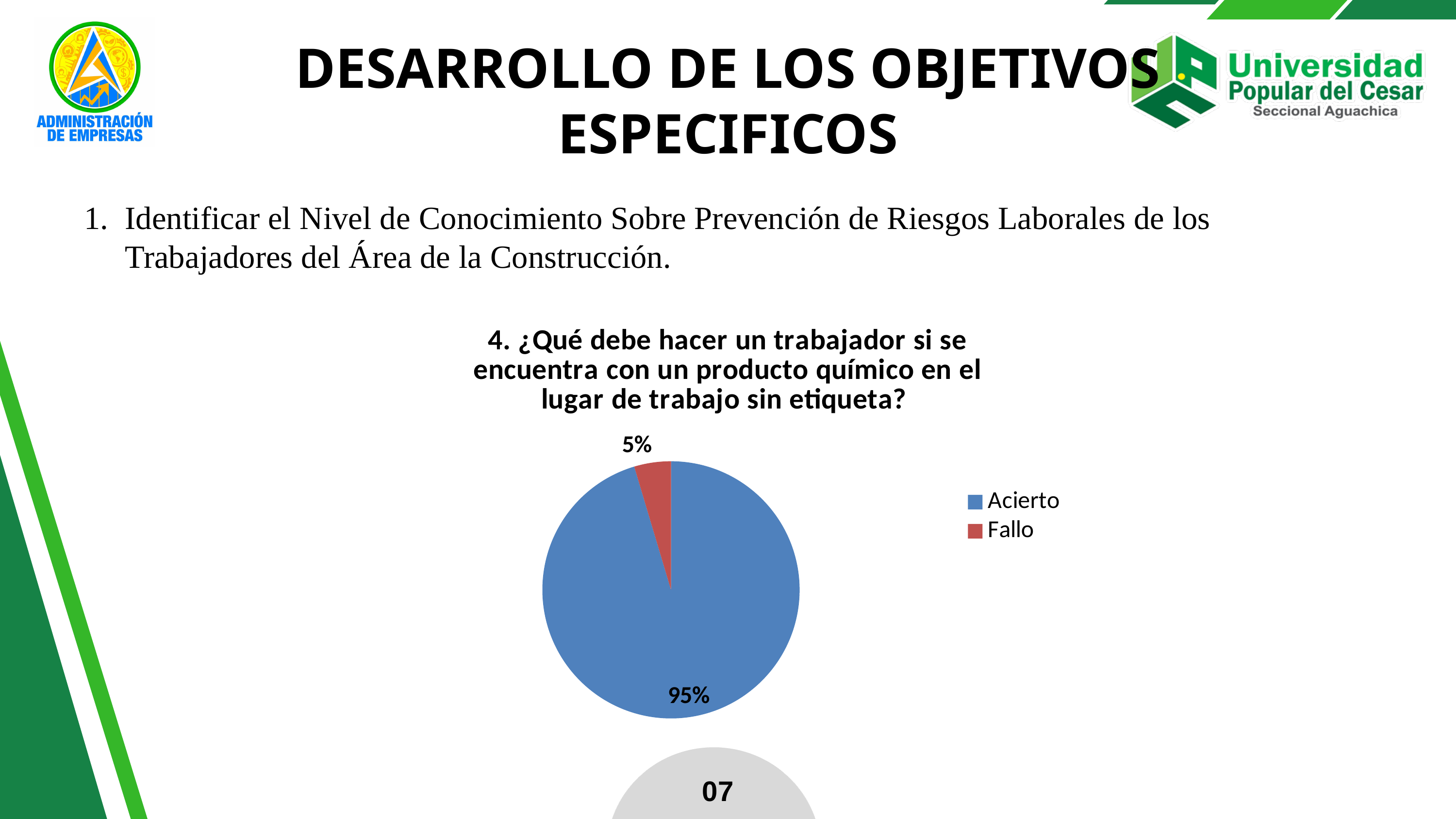
What is the difference in percentage points between the Acierto and Fallo slices? 90 Which slice is larger, Acierto or Fallo? Acierto What type of chart is shown on the slide? Pie chart Which category has the smallest share of the pie chart? Fallo What is the title of the pie chart? 4. ¿Qué debe hacer un trabajador si se encuentra con un producto químico en el lugar de trabajo sin etiqueta? What share of the pie does the Fallo slice represent? 5% What colour is the Acierto slice in the pie chart? Blue How many slices does the pie chart have? 2 What percentage of the pie chart is labelled Acierto? 95% How many entries does the chart legend list? 2 Which category has the largest share of the pie chart? Acierto What percentage of the pie chart is labelled Fallo? 5%